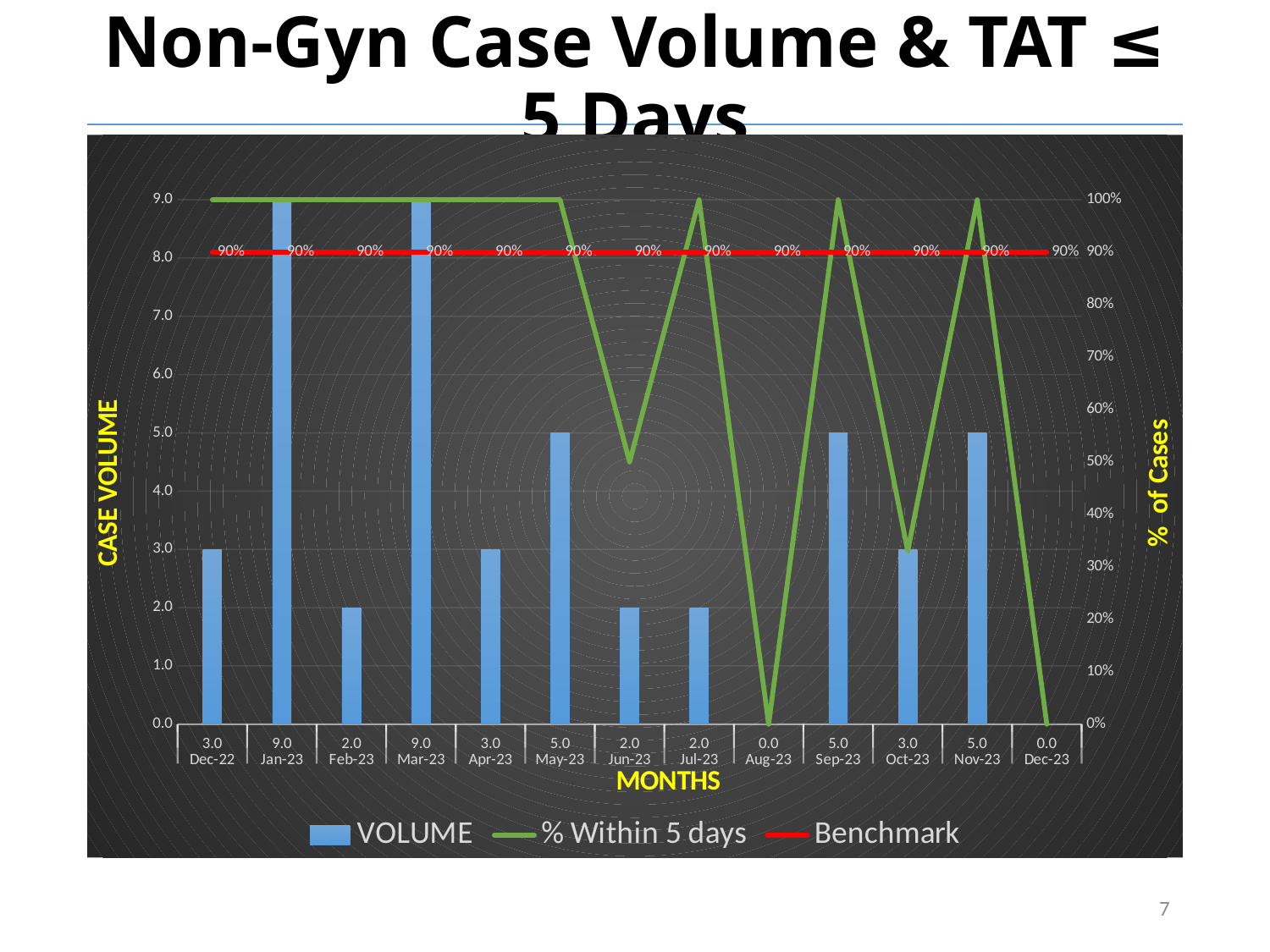
What is the VOLUME value for Jan-23? 9.0 Which months have a VOLUME of 0.0? Aug-23 and Dec-23 Is the % Within 5 days value for Jul-23 greater or less than 90%? greater What is the VOLUME value for Sep-23? 5.0 What is the label of the left vertical axis? CASE VOLUME What is the Benchmark value shown for each month? 90% How many months are shown on the x axis? 13 Is the % Within 5 days value for Oct-23 greater or less than 50%? less Which months have the highest VOLUME? Jan-23 and Mar-23 How many series does the legend list? 3 What is the difference in VOLUME between Mar-23 and Apr-23? 6.0 Which month has a larger VOLUME, May-23 or Jun-23? May-23